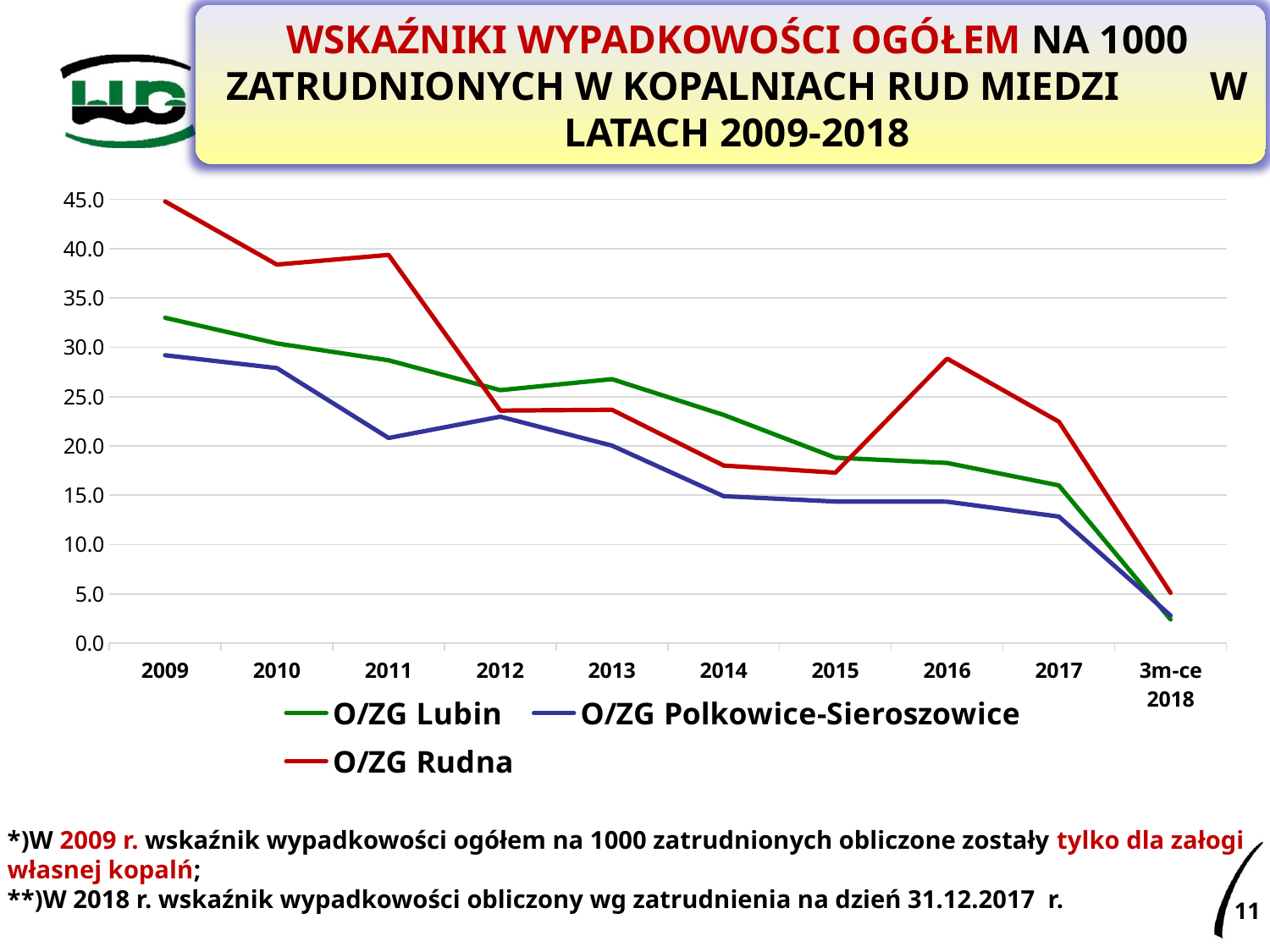
In 2016, which is larger: the value for O/ZG Rudna or O/ZG Lubin? O/ZG Rudna Does the value for O/ZG Lubin rise or fall from 2009 to 2017? fall Is the value for O/ZG Lubin in 2009 greater or less than 35.0? less How many series does the legend list? 3 In 2011, which is larger: the value for O/ZG Rudna or O/ZG Polkowice-Sieroszowice? O/ZG Rudna What kind of chart is shown on the slide? line chart Which series has the lowest value in 2017? O/ZG Polkowice-Sieroszowice Is the value for O/ZG Rudna in 2009 greater or less than 40.0? greater How many points are shown along the x axis? 10 Which series has the highest value in 2009? O/ZG Rudna Is the value for O/ZG Rudna in 2016 greater or less than 25.0? greater